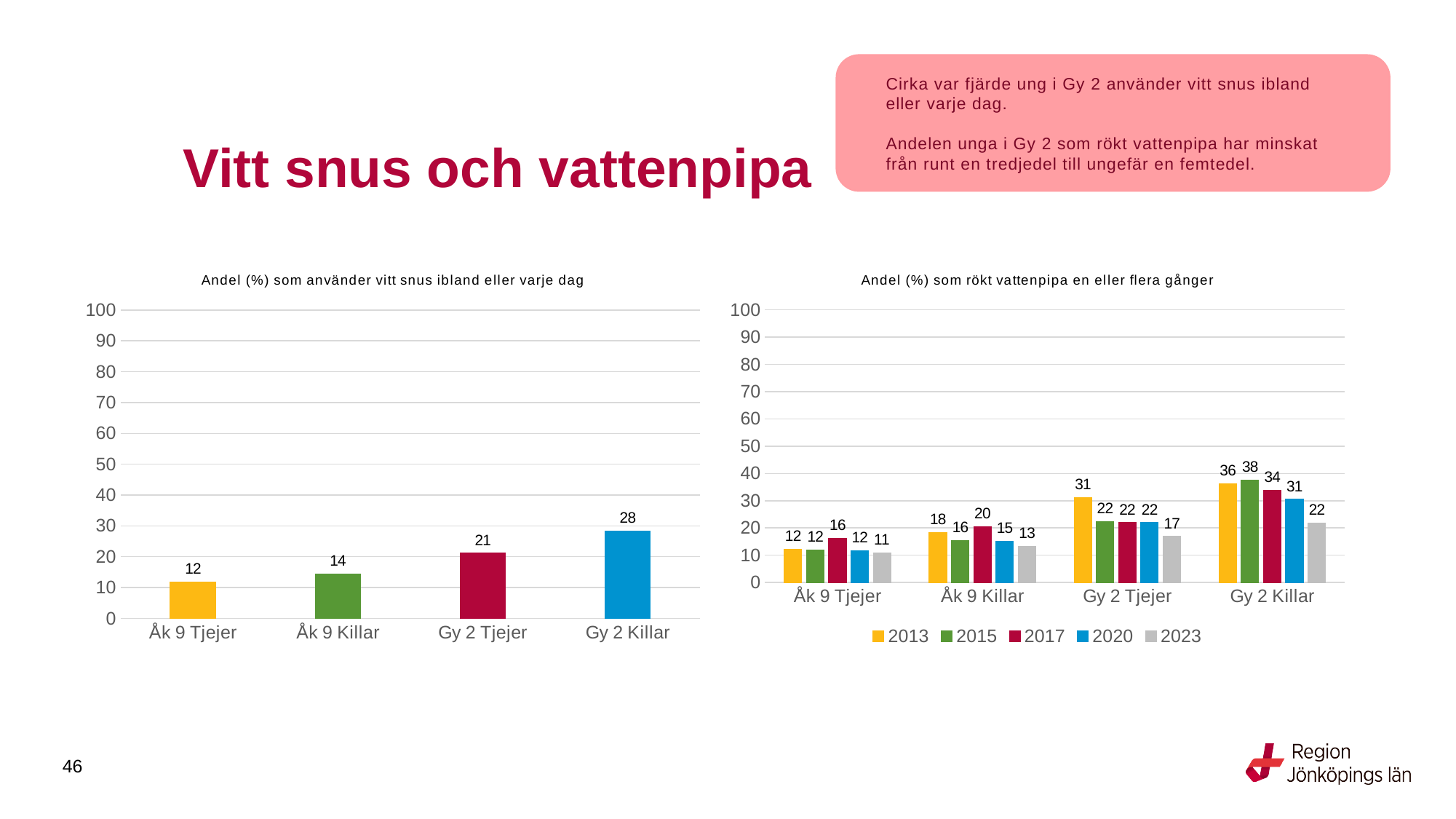
In the left chart 'Andel (%) som använder vitt snus ibland eller varje dag', which category has the lowest value? Åk 9 Tjejer In the left chart 'Andel (%) som använder vitt snus ibland eller varje dag', do the values rise or fall from left to right? rise In the right chart 'Andel (%) som rökt vattenpipa en eller flera gånger', what is the difference between the 2013 and 2023 values for Gy 2 Killar? 14 What kind of chart is the right chart 'Andel (%) som rökt vattenpipa en eller flera gånger'? bar chart In the right chart 'Andel (%) som rökt vattenpipa en eller flera gånger', which is larger: Åk 9 Killar in 2017 or Åk 9 Tjejer in 2017? Åk 9 Killar in 2017 In the right chart 'Andel (%) som rökt vattenpipa en eller flera gånger', what is the value for Gy 2 Tjejer in 2013? 31 In the right chart 'Andel (%) som rökt vattenpipa en eller flera gånger', how many series does the legend list? 5 In the left chart 'Andel (%) som använder vitt snus ibland eller varje dag', what is the value for Gy 2 Killar? 28 In the right chart 'Andel (%) som rökt vattenpipa en eller flera gånger', which year has the highest value for Gy 2 Killar? 2015 In the left chart 'Andel (%) som använder vitt snus ibland eller varje dag', how many categories are shown? 4 In the left chart 'Andel (%) som använder vitt snus ibland eller varje dag', what is the difference between Gy 2 Killar and Åk 9 Tjejer? 16 In the right chart 'Andel (%) som rökt vattenpipa en eller flera gånger', what is the value for Åk 9 Killar in 2023? 13